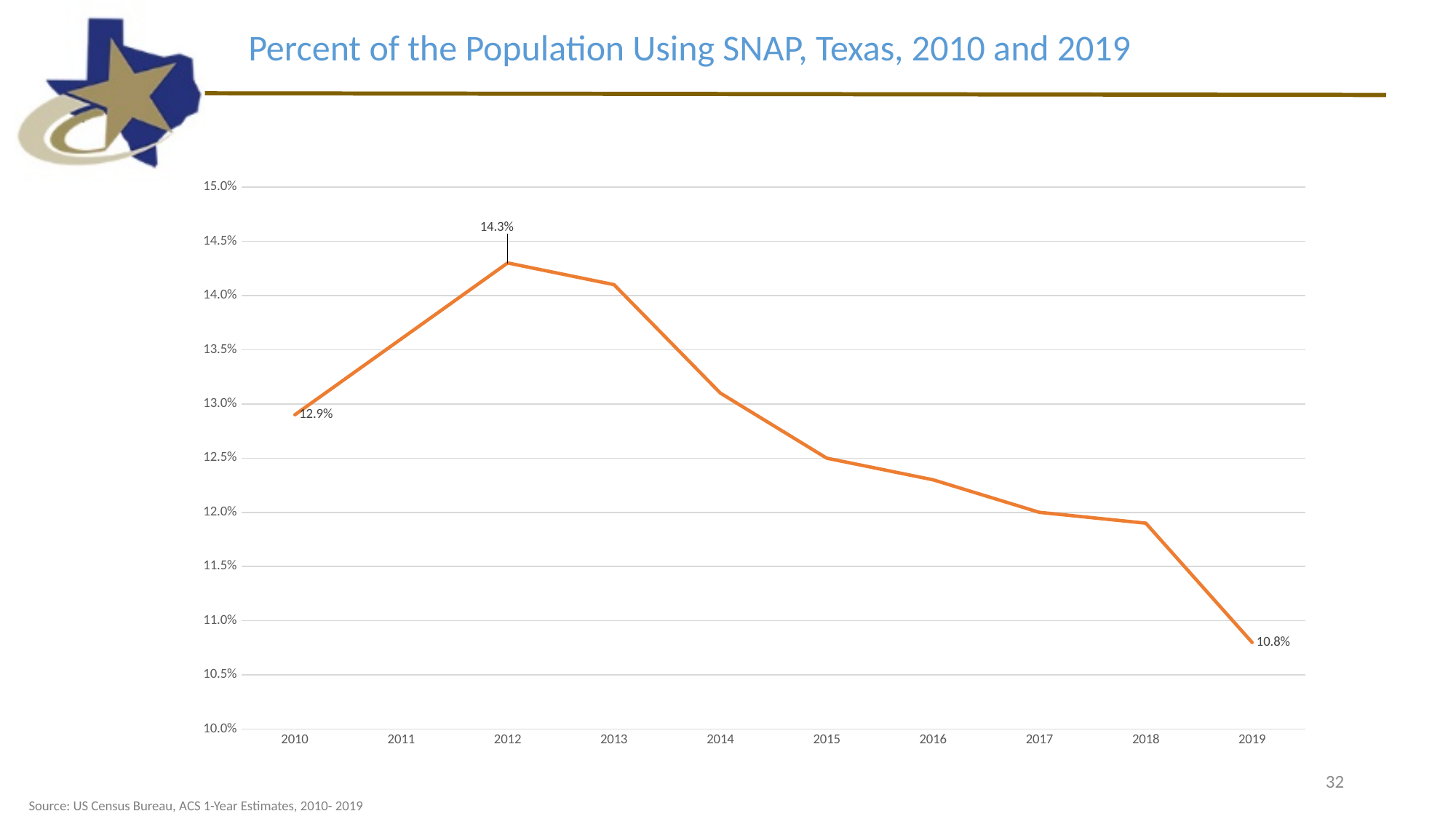
What was the percent of the population using SNAP in Texas in 2012? 14.3% Do the values rise or fall from 2012 to 2019? Fall What was the percent of the population using SNAP in Texas in 2010? 12.9% What type of chart is shown on the slide? Line chart Which year has the highest percent of the population using SNAP? 2012 Is the value for 2016 greater or less than 12.5%? less By how many percentage points did the SNAP usage rate fall from 2012 to 2019? 3.5 percentage points Which year has the lowest percent of the population using SNAP? 2019 What was the percent of the population using SNAP in Texas in 2019? 10.8% Which is larger, the value for 2010 or the value for 2019? 2010 How many years are plotted on the x axis? 10 What is the difference between the 2012 value and the 2010 value? 1.4 percentage points